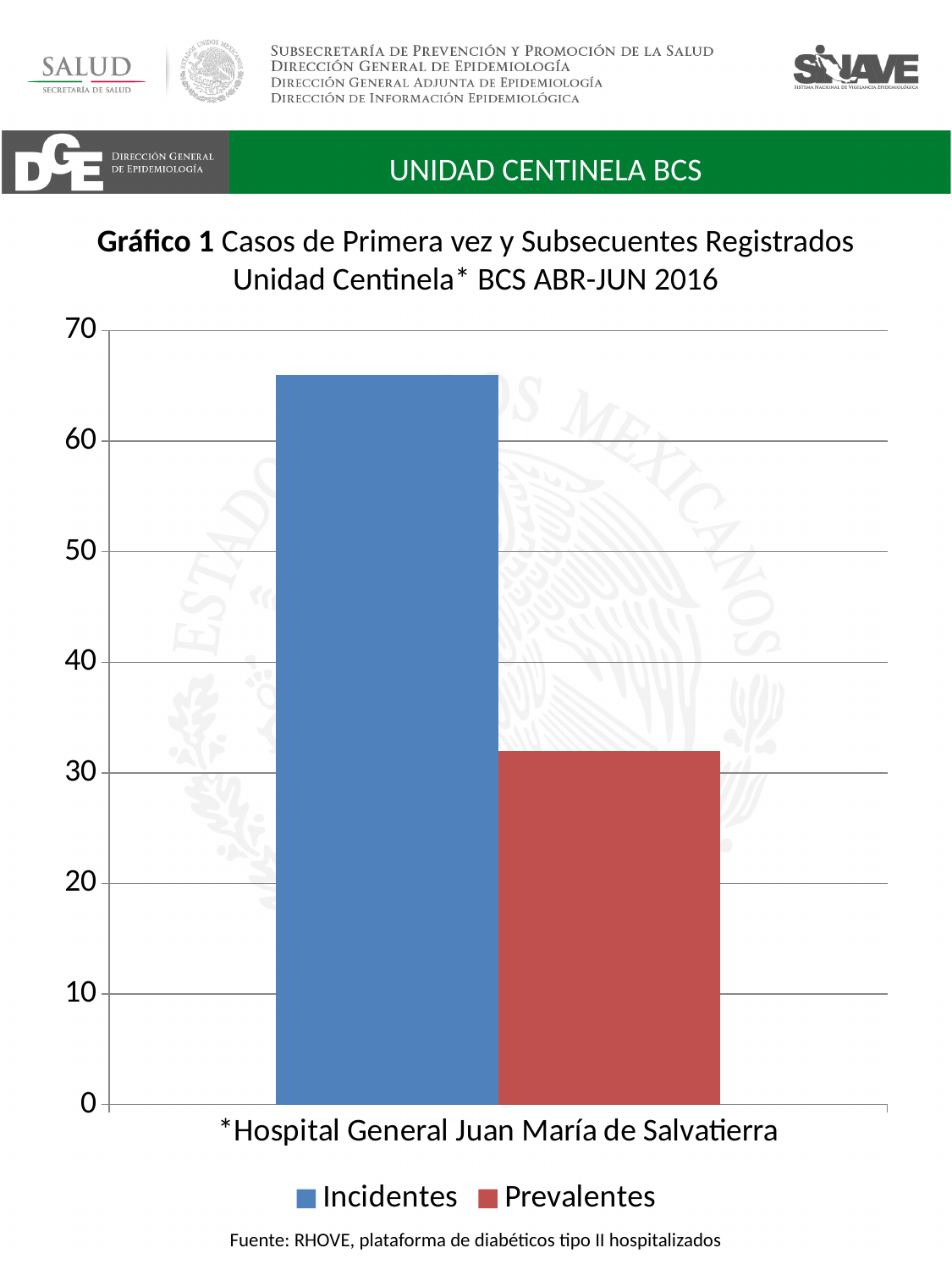
Is the value for Incidentes greater or less than 70? less Is the value for Incidentes greater or less than 60? greater What kind of chart is shown on the slide? bar chart Which series has the taller bar, Incidentes or Prevalentes? Incidentes Which series has the highest value? Incidentes What colour is the bar for Prevalentes? red Is the value for Prevalentes greater or less than 40? less How many series does the legend list? 2 Which series has the lowest value? Prevalentes How many categories are shown on the x axis? 1 What is the name of the hospital given as the category label on the x axis? Hospital General Juan María de Salvatierra